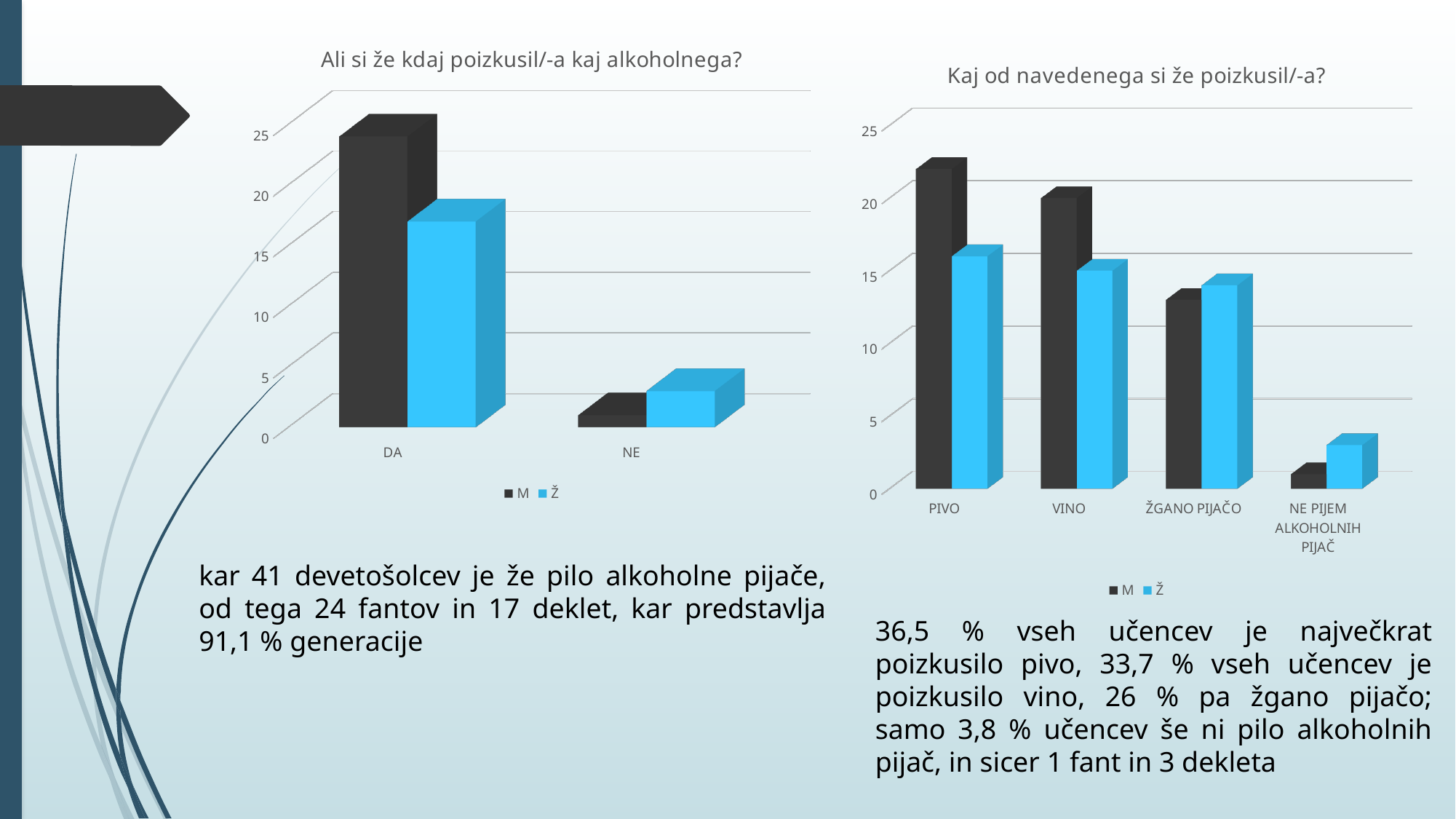
In the right chart "Kaj od navedenega si že poizkusil/-a?", which category has the lowest value for series Ž? NE PIJEM ALKOHOLNIH PIJAČ In the right chart "Kaj od navedenega si že poizkusil/-a?", how many categories are shown on the x axis? 4 What are the two legend entries in the right chart "Kaj od navedenega si že poizkusil/-a?"? M and Ž In the right chart "Kaj od navedenega si že poizkusil/-a?", which series has the larger value for PIVO, M or Ž? M In the left chart "Ali si že kdaj poizkusil/-a kaj alkoholnega?", is the value for Ž at NE greater or less than 5? less In the right chart "Kaj od navedenega si že poizkusil/-a?", is the value for M at PIVO greater or less than 20? greater In the right chart "Kaj od navedenega si že poizkusil/-a?", which category has the highest value for series M? PIVO What kind of chart is the left chart titled "Ali si že kdaj poizkusil/-a kaj alkoholnega?"? bar chart In the right chart "Kaj od navedenega si že poizkusil/-a?", is the value for Ž at VINO greater or less than 20? less In the left chart "Ali si že kdaj poizkusil/-a kaj alkoholnega?", which series has the larger value for DA, M or Ž? M In the left chart "Ali si že kdaj poizkusil/-a kaj alkoholnega?", how many series does the legend list? 2